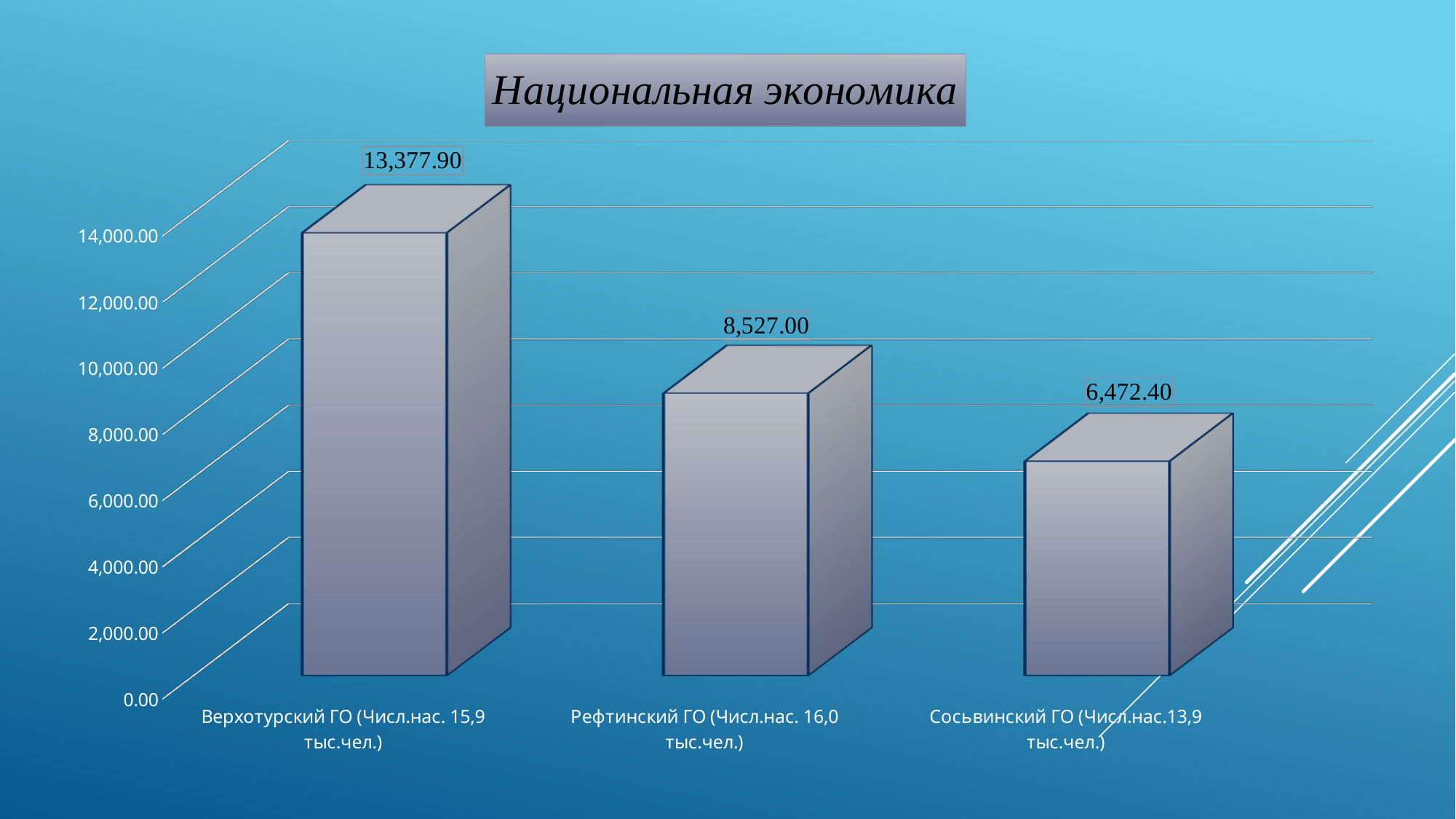
What is the difference between the values for Рефтинский ГО and Сосьвинский ГО? 2,054.60 What is the value for Рефтинский ГО? 8,527.00 Is the value for Сосьвинский ГО greater or less than 8,000.00? less What is the value for Сосьвинский ГО? 6,472.40 What is the value for Верхотурский ГО? 13,377.90 What is the difference between the values for Верхотурский ГО and Рефтинский ГО? 4,850.90 How many categories are shown in the chart? 3 Which is larger, the value for Рефтинский ГО or Сосьвинский ГО? Рефтинский ГО What kind of chart is shown on the slide? bar chart What is the title of the slide? Национальная экономика Which category has the lowest value? Сосьвинский ГО Which category has the highest value? Верхотурский ГО